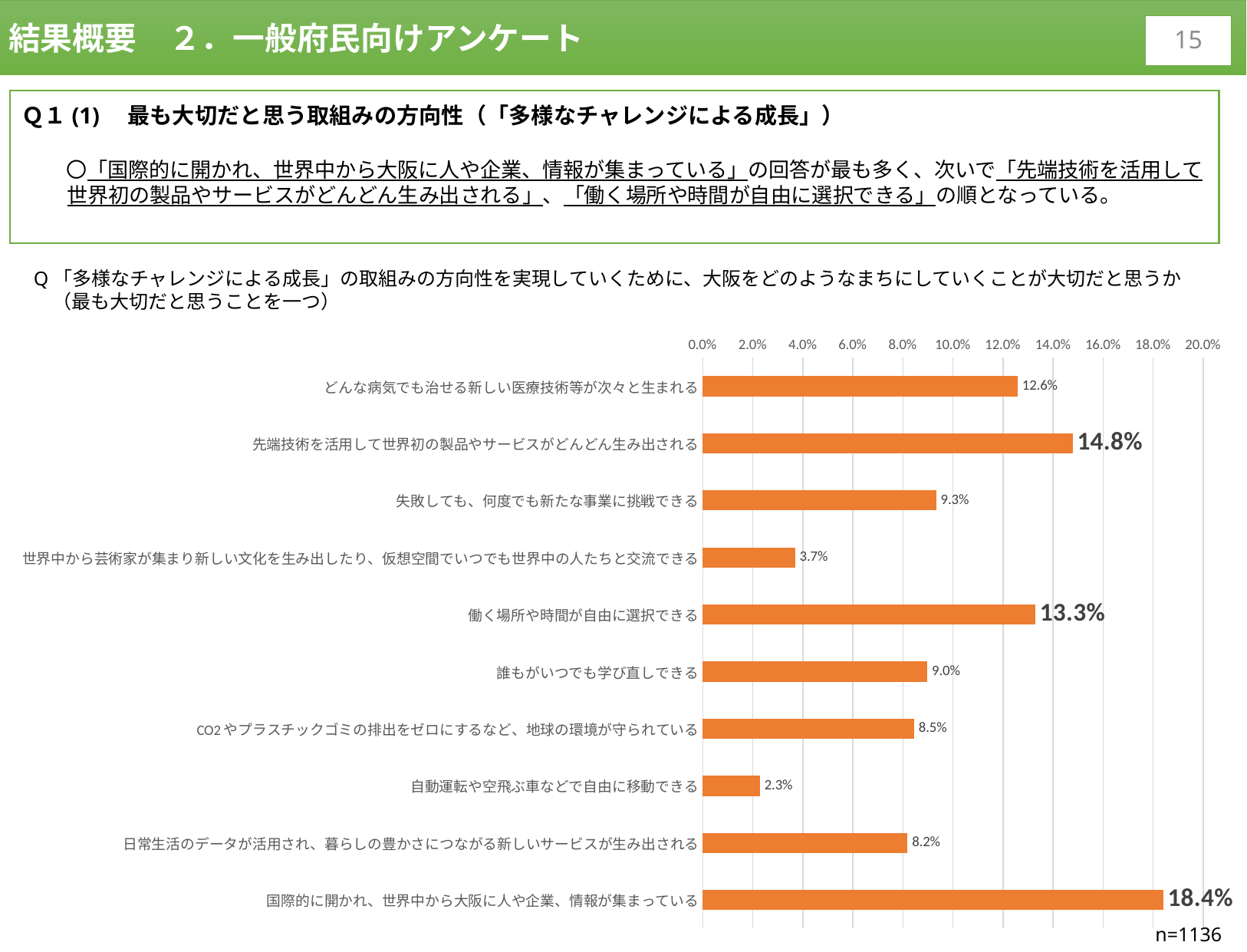
What is the sample size (n) shown below the chart? n=1136 How many categories are shown in the chart? 10 What is the maximum value shown on the chart's axis? 20.0% Which is larger: the value for 「失敗しても、何度でも新たな事業に挑戦できる」 or 「誰もがいつでも学び直しできる」? 失敗しても、何度でも新たな事業に挑戦できる What is the value for 「働く場所や時間が自由に選択できる」? 13.3% What is the value for 「国際的に開かれ、世界中から大阪に人や企業、情報が集まっている」? 18.4% Is the value for 「世界中から芸術家が集まり新しい文化を生み出したり、仮想空間でいつでも世界中の人たちと交流できる」 greater or less than 4.0%? less Which category has the highest value? 国際的に開かれ、世界中から大阪に人や企業、情報が集まっている Which category has the lowest value? 自動運転や空飛ぶ車などで自由に移動できる What is the value for 「自動運転や空飛ぶ車などで自由に移動できる」? 2.3% What is the difference between the values for 「先端技術を活用して世界初の製品やサービスがどんどん生み出される」 and 「どんな病気でも治せる新しい医療技術等が次々と生まれる」? 2.2% What kind of chart is shown on the slide? bar chart